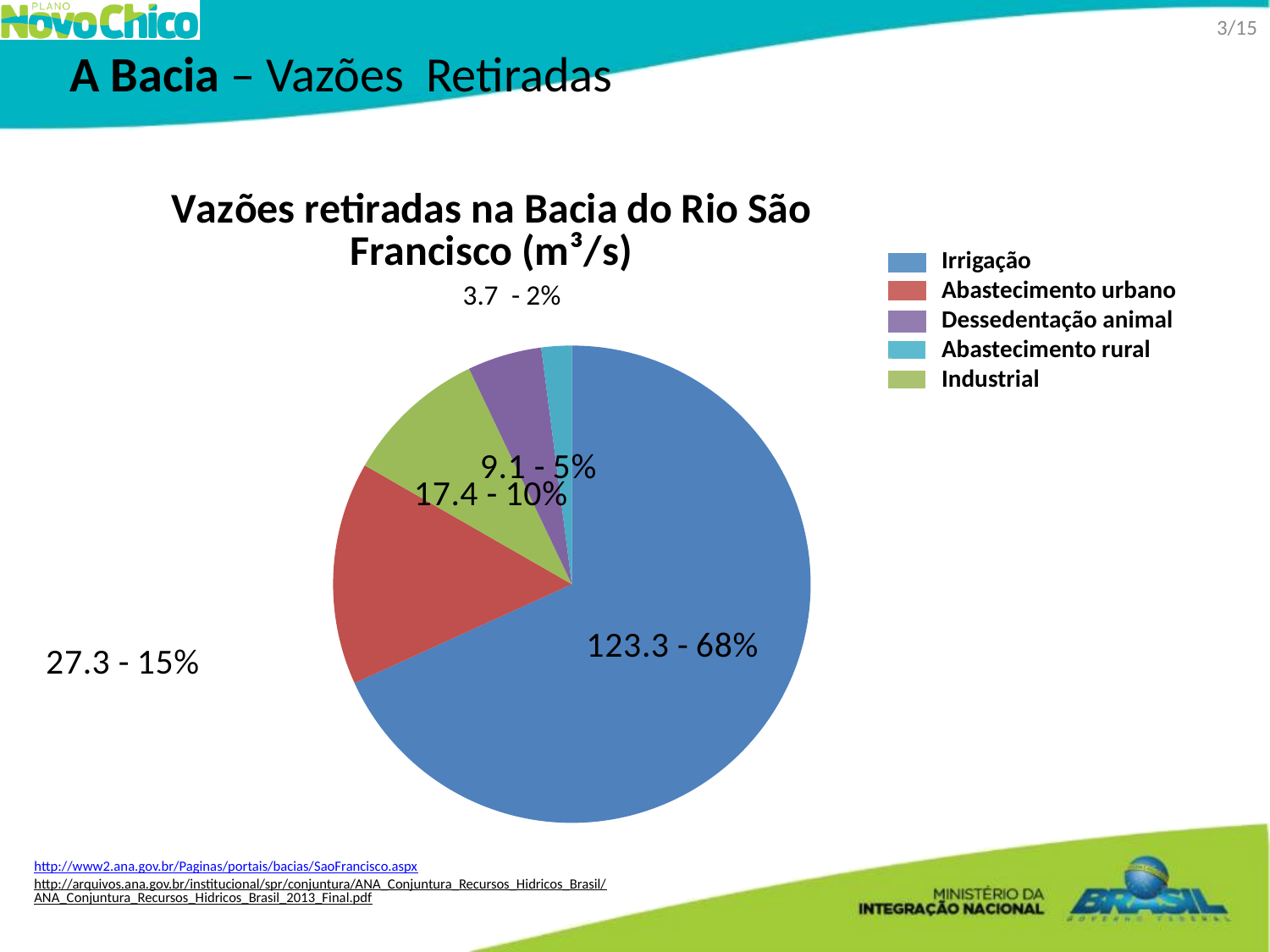
What is the value for Dessedentação animal in the pie chart? 9.1 Which category has the smallest slice of the pie? Abastecimento rural How many categories does the pie chart have? 5 What share of the pie does Abastecimento urbano represent? 15% What kind of chart is shown on the slide? pie chart What is the value for Industrial in the pie chart? 17.4 What is the difference between the values for Irrigação and Abastecimento urbano? 96 What is the value for Abastecimento rural in the pie chart? 3.7 What is the value for Abastecimento urbano in the pie chart? 27.3 What is the title of the pie chart? Vazões retiradas na Bacia do Rio São Francisco (m³/s) Which category has the largest slice of the pie? Irrigação What is the value for Irrigação in the pie chart? 123.3